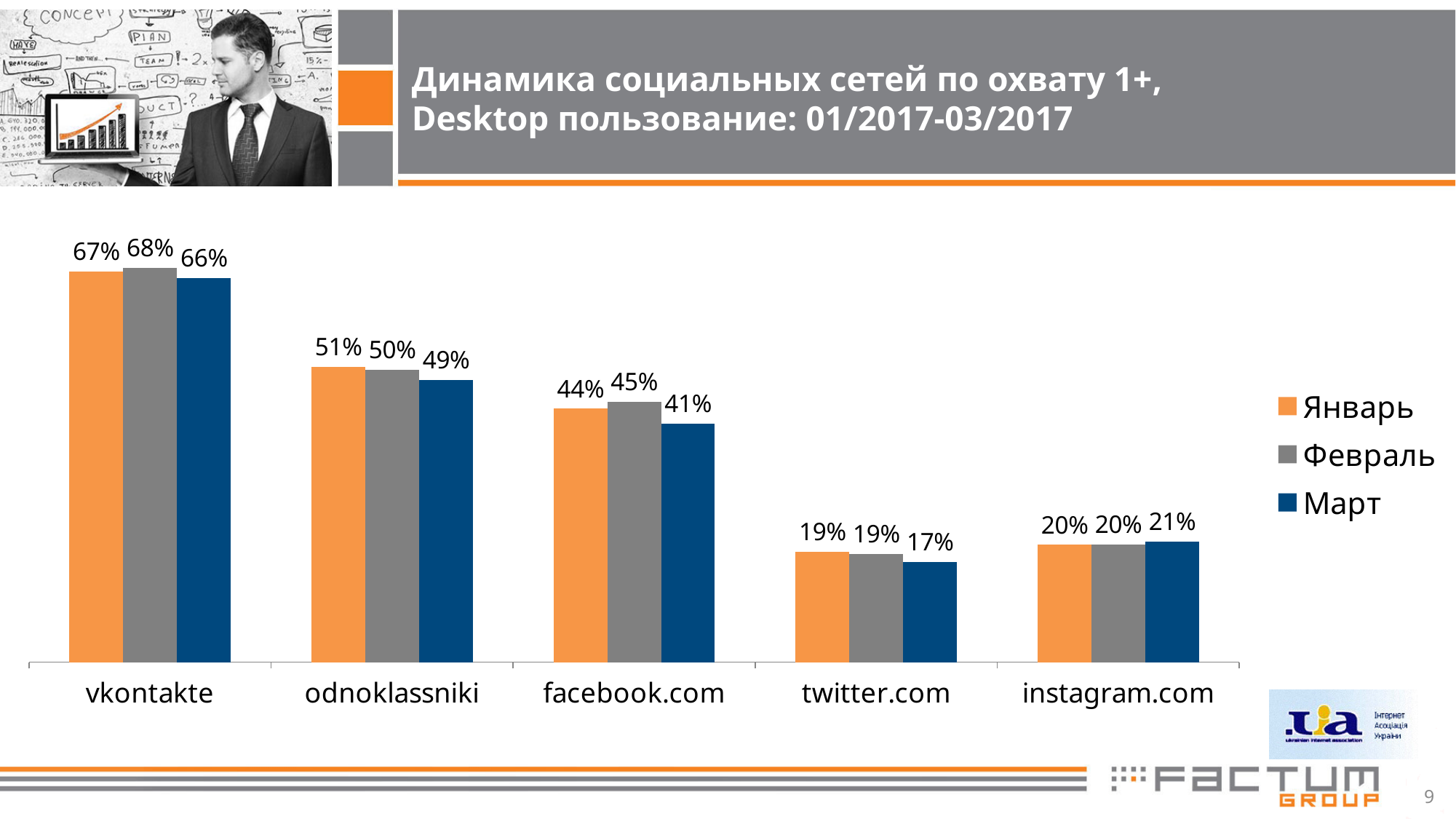
What is the difference between the Январь and Март values for facebook.com? 3% How many series does the legend list? 3 How many categories are shown on the x axis? 5 What is the value for instagram.com in Март? 21% Which is larger: the Март value for odnoklassniki or the Март value for facebook.com? odnoklassniki Which legend entry is shown in orange? Январь What is the value for facebook.com in Март? 41% What is the value for twitter.com in Январь? 19% What is the value for vkontakte in Февраль? 68% Which category has the lowest value in the Март series? twitter.com Which category has the highest value in the Январь series? vkontakte What kind of chart is shown on the slide? bar chart